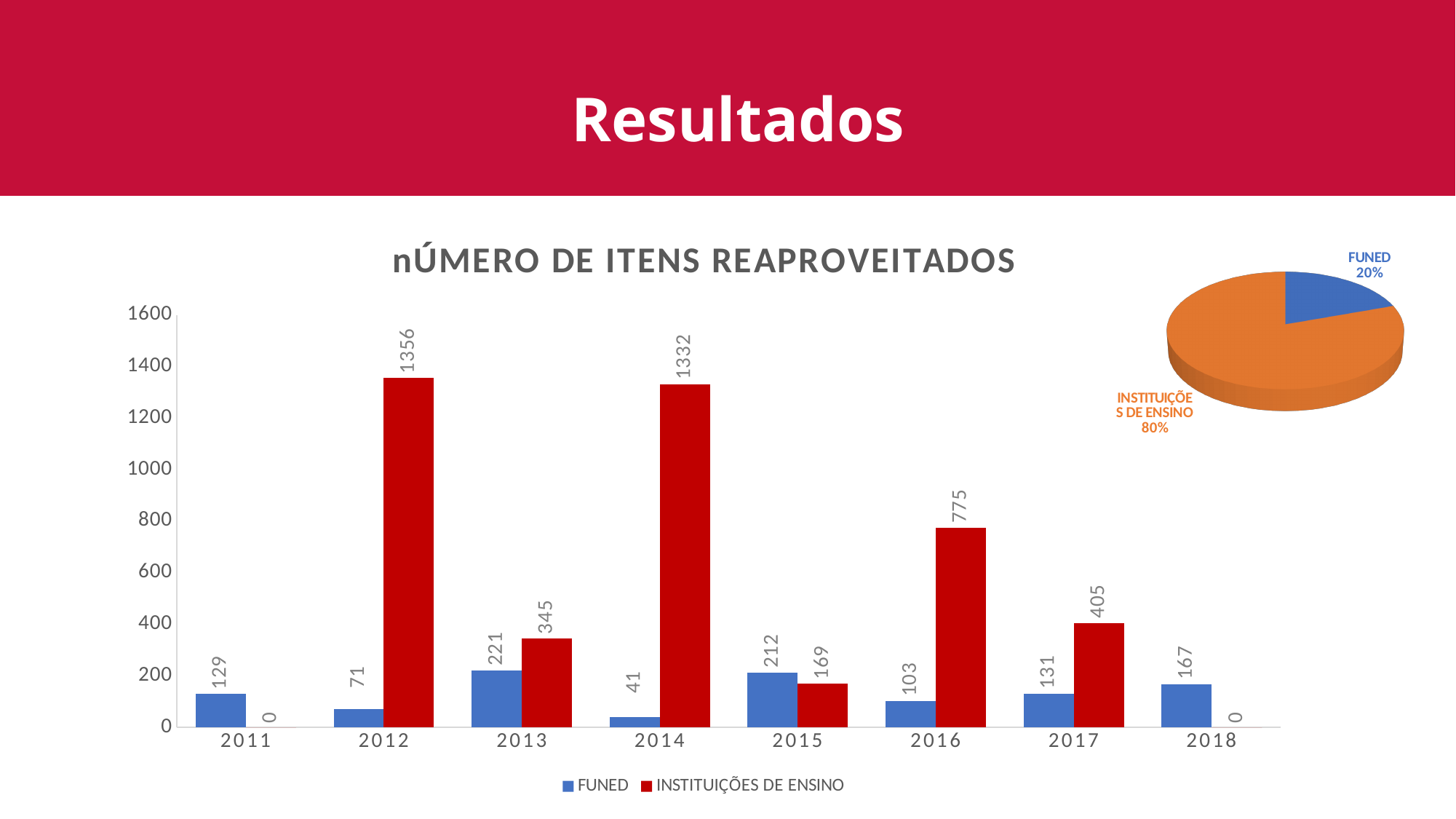
In the bar chart 'nÚMERO DE ITENS REAPROVEITADOS', what is the difference between the INSTITUIÇÕES DE ENSINO values for 2012 and 2014? 24 In the bar chart 'nÚMERO DE ITENS REAPROVEITADOS', what is the value for INSTITUIÇÕES DE ENSINO in 2012? 1356 In the bar chart 'nÚMERO DE ITENS REAPROVEITADOS', is the value for INSTITUIÇÕES DE ENSINO in 2016 greater or less than 600? greater In the bar chart 'nÚMERO DE ITENS REAPROVEITADOS', which year has the highest value for FUNED? 2013 In the bar chart 'nÚMERO DE ITENS REAPROVEITADOS', which is larger in 2015: FUNED or INSTITUIÇÕES DE ENSINO? FUNED How many series does the legend of the bar chart 'nÚMERO DE ITENS REAPROVEITADOS' list? 2 How many years are shown on the x axis of the bar chart 'nÚMERO DE ITENS REAPROVEITADOS'? 8 In the bar chart 'nÚMERO DE ITENS REAPROVEITADOS', which year has the lowest value for FUNED? 2014 In the bar chart 'nÚMERO DE ITENS REAPROVEITADOS', what is the value for FUNED in 2015? 212 What kind of chart is the chart at the top right of the slide? Pie chart In the pie chart at the top right of the slide, what share does FUNED have? 20% In the bar chart 'nÚMERO DE ITENS REAPROVEITADOS', what is the value for INSTITUIÇÕES DE ENSINO in 2018? 0